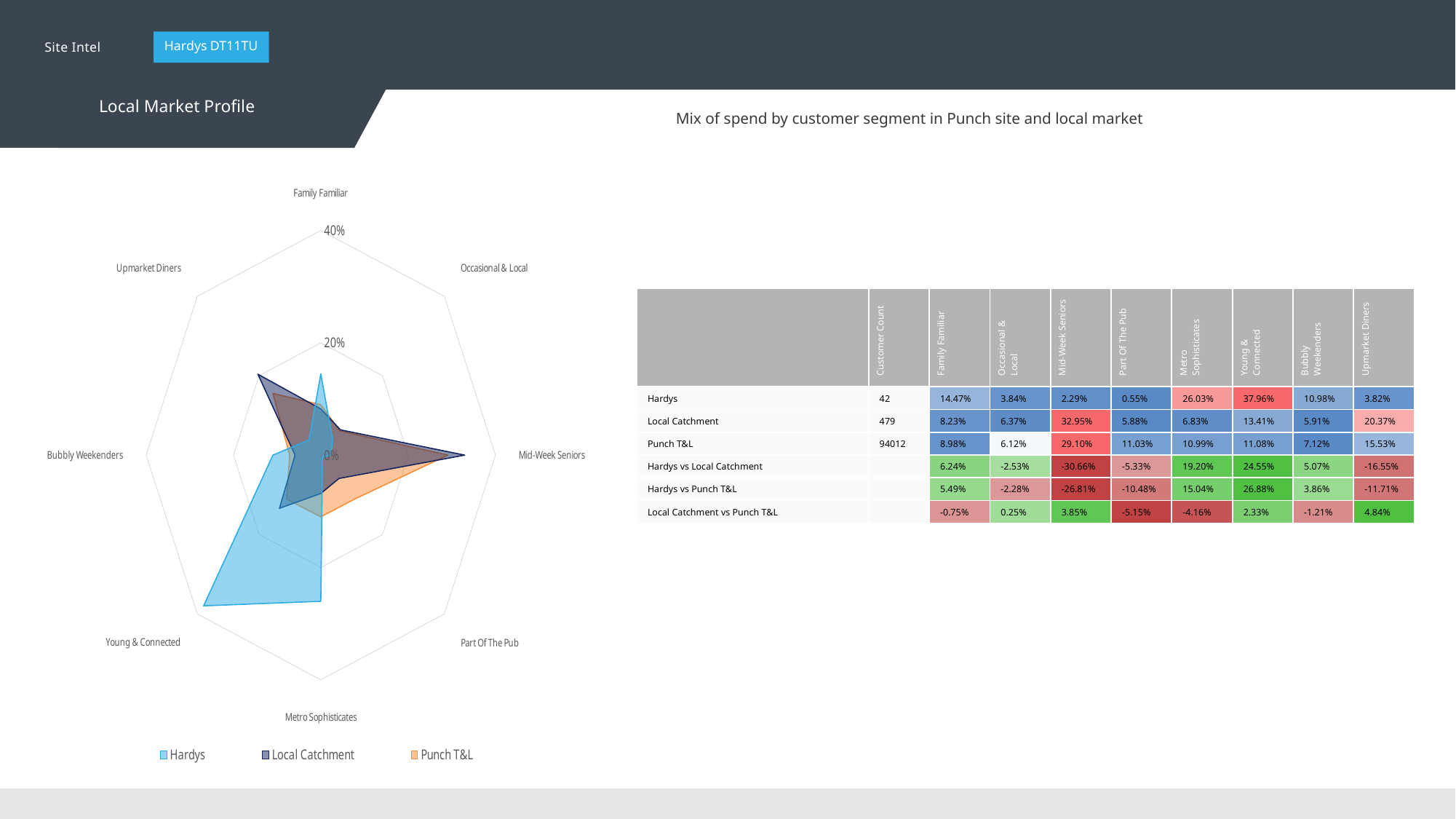
Is the Hardys value for Young & Connected greater or less than 20%? greater Which customer segment has the lowest value for Hardys? Part Of The Pub What is the Hardys value for Metro Sophisticates? 26.03% What is the Punch T&L value for Mid-Week Seniors? 29.10% How many series does the legend of the radar chart list? 3 What is the difference between the Hardys and Local Catchment values for Metro Sophisticates? 19.20% Is the Local Catchment value for Family Familiar greater or less than 20%? less What kind of chart is shown on the left of the slide? Radar chart For Upmarket Diners, which is larger: Hardys or Local Catchment? Local Catchment How many customer segments are plotted around the radar chart? 8 Which customer segment has the highest value for Local Catchment? Mid-Week Seniors Which customer segment has the highest value for Hardys? Young & Connected